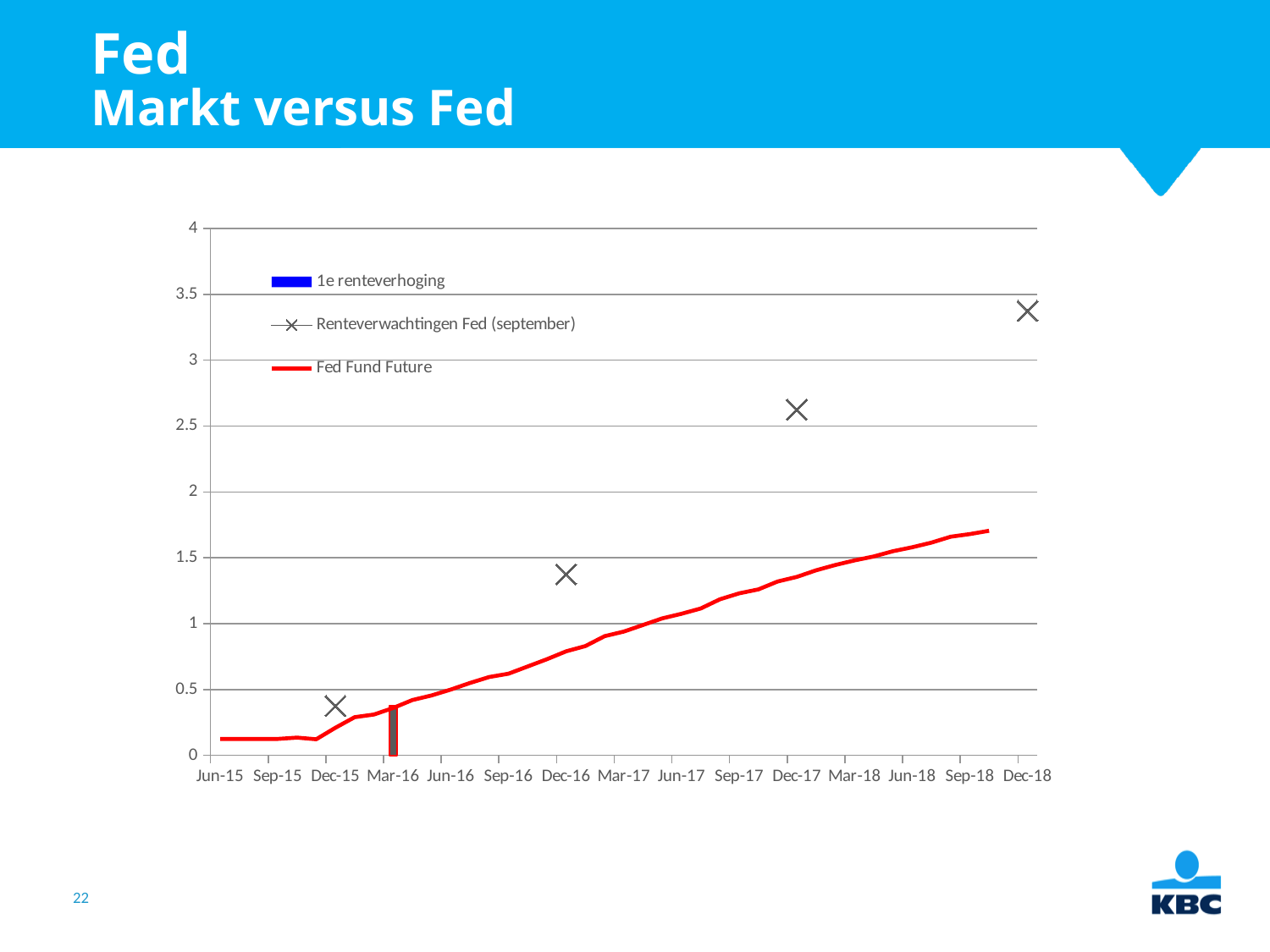
Is the Fed Fund Future value at Sep-18 greater or less than 1.5? greater Is the Renteverwachtingen Fed (september) value at Dec-17 greater or less than 2? greater What colour is the Fed Fund Future line in the legend? red Does the Fed Fund Future series rise or fall from Jun-15 to Sep-18? rise Is the Fed Fund Future value at Jun-15 greater or less than 0.5? less How many X markers are plotted for the Renteverwachtingen Fed (september) series? 4 How many date labels are shown on the x axis? 15 What kind of chart is shown on the slide? combination bar and line chart How many series does the chart legend list? 3 At Dec-17, which is higher: Renteverwachtingen Fed (september) or Fed Fund Future? Renteverwachtingen Fed (september)